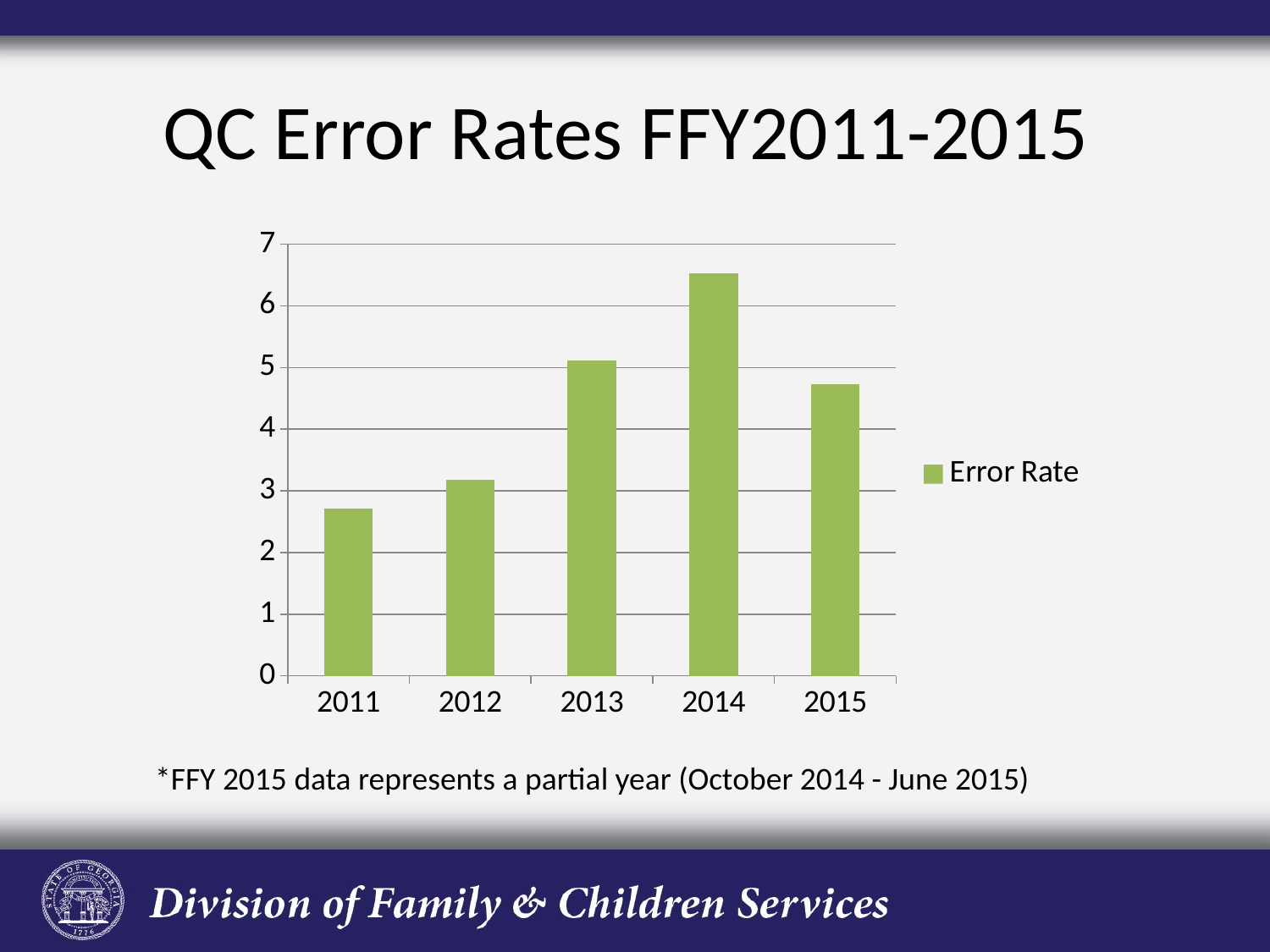
Is the error rate for 2013 greater or less than 5? greater Is the error rate for 2015 greater or less than 5? less How many series does the legend list? 1 Is the error rate for 2014 greater or less than 6? greater What kind of chart is shown on the slide? bar chart Do the error rates rise or fall from 2011 to 2014? rise Which year has the highest error rate? 2014 Which year has the lowest error rate? 2011 How many years are shown on the x axis? 5 Which year has a higher error rate, 2012 or 2011? 2012 Which year has a higher error rate, 2013 or 2015? 2013